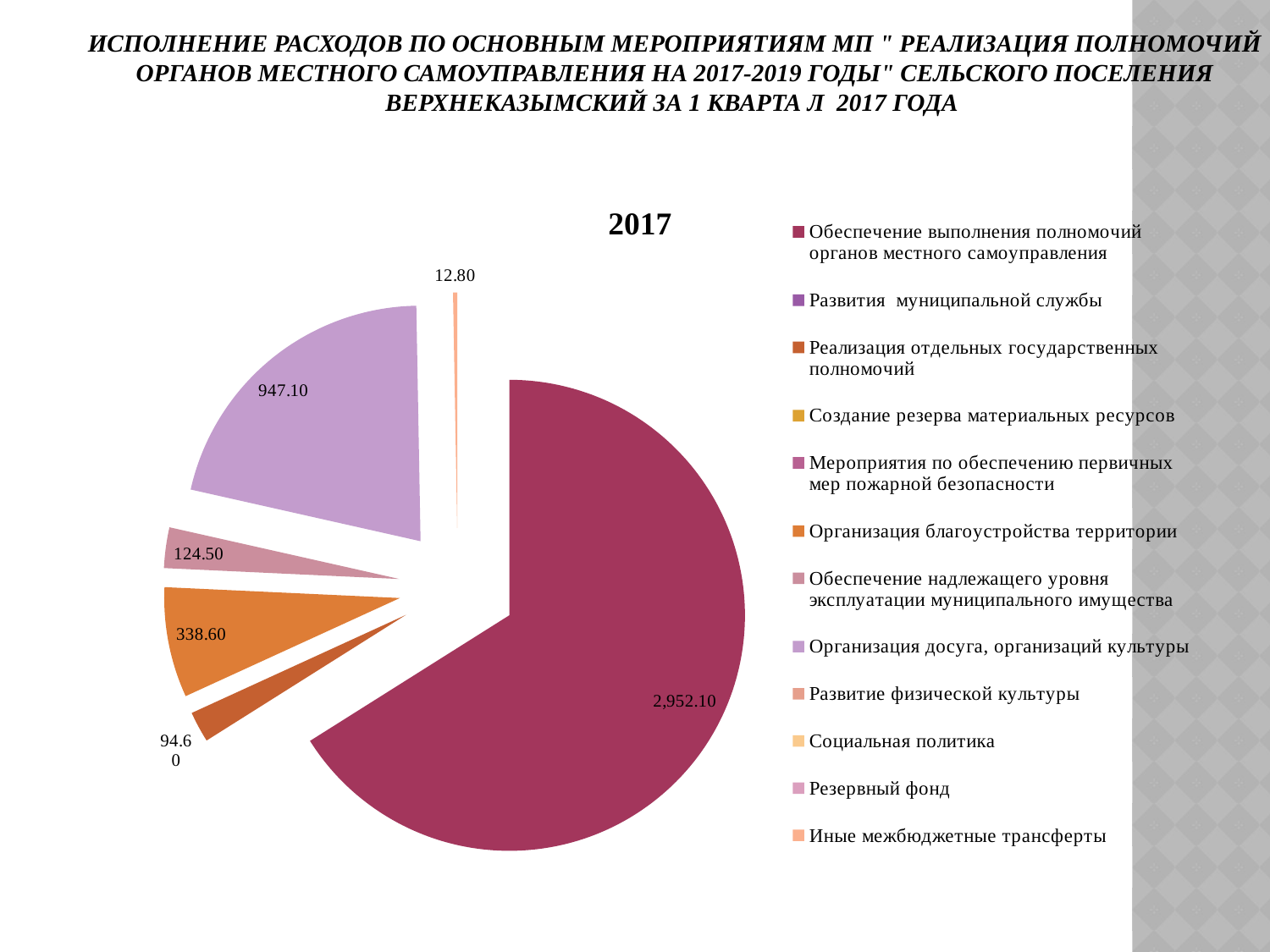
Which is larger: the value for "Обеспечение надлежащего уровня эксплуатации муниципального имущества" or for "Реализация отдельных государственных полномочий"? Обеспечение надлежащего уровня эксплуатации муниципального имущества What is the value shown for "Организация досуга, организаций культуры"? 947.10 How many slices have a data label printed on the pie chart? 6 What kind of chart is shown on the slide? pie chart What is the difference between the values for "Организация досуга, организаций культуры" and "Организация благоустройства территории"? 608.50 How many entries does the legend list? 12 Which category has the largest slice of the pie? Обеспечение выполнения полномочий органов местного самоуправления What is the title shown above the pie chart? 2017 What is the smallest value labelled on the pie chart? 12.80 What is the value shown for "Организация благоустройства территории"? 338.60 What is the value shown for "Обеспечение выполнения полномочий органов местного самоуправления"? 2,952.10 What is the value shown for "Обеспечение надлежащего уровня эксплуатации муниципального имущества"? 124.50